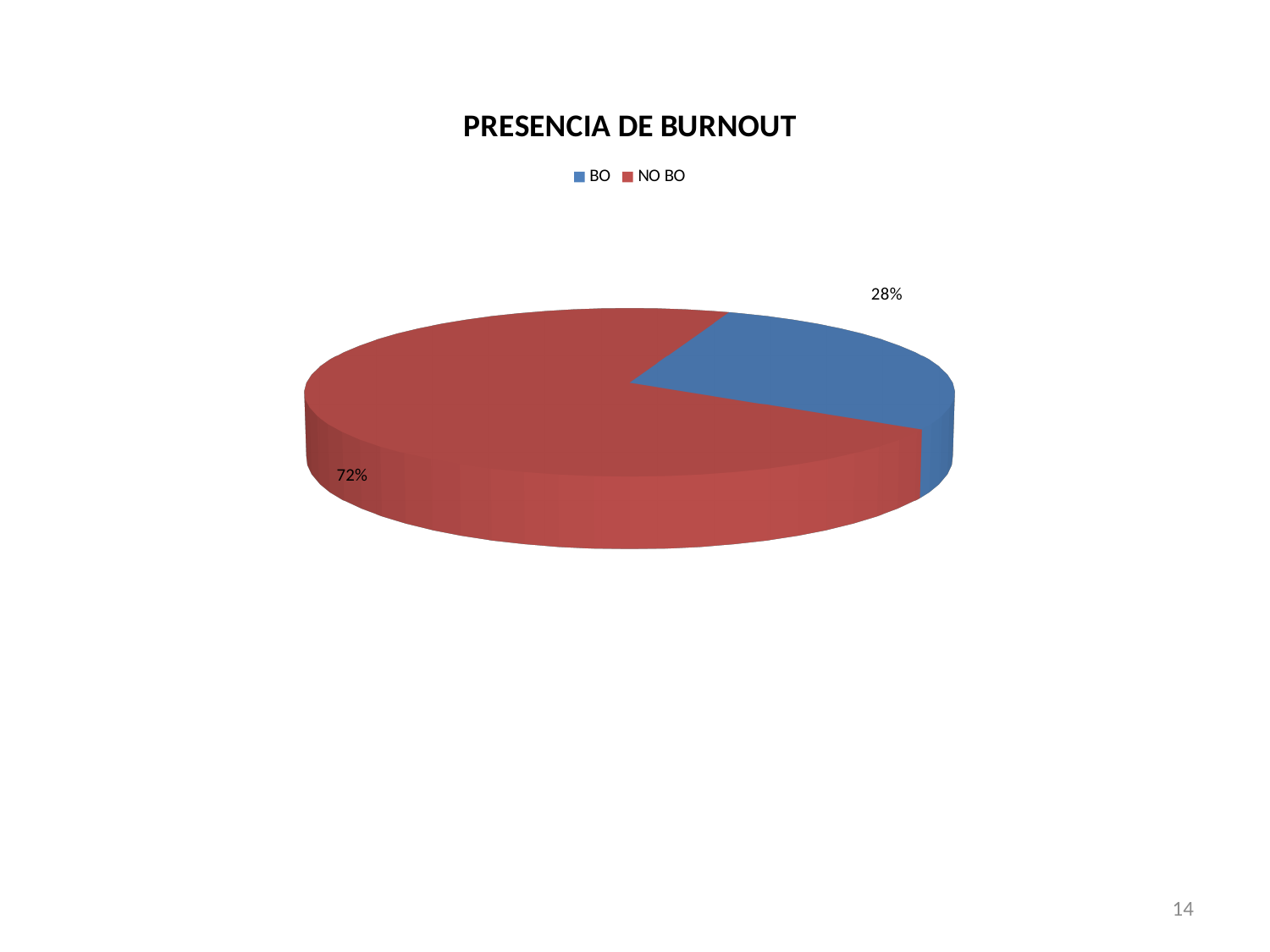
Which slice is the largest? NO BO What colour is the NO BO slice? red What is the title of the chart? PRESENCIA DE BURNOUT How many entries does the legend list? 2 How many slices does the pie chart have? 2 What share of the pie does BO represent? 28% What share of the pie does NO BO represent? 72% Which is larger, BO or NO BO? NO BO What is the difference in percentage points between NO BO and BO? 44 Which slice is the smallest? BO What kind of chart is shown on the slide? pie chart